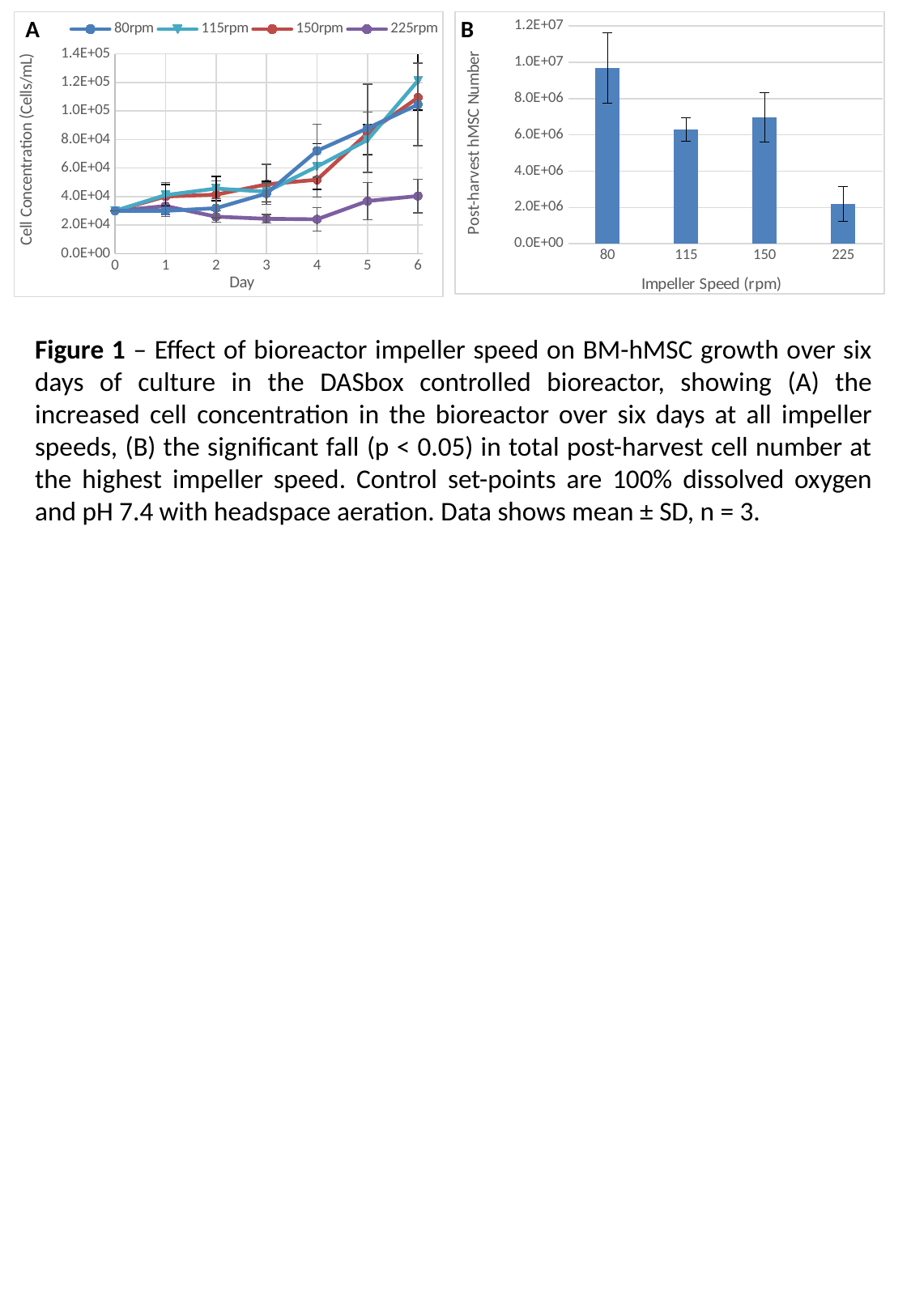
In chart B, is the post-harvest hMSC number for 80 rpm greater or less than 8.0E+06? greater In chart B, is the post-harvest hMSC number for 150 rpm greater or less than 8.0E+06? less In chart B, which impeller speed has the highest post-harvest hMSC number? 80 In chart B, is the post-harvest hMSC number for 225 rpm greater or less than 4.0E+06? less How many series does the legend of chart A list? 4 In chart B, which has a larger post-harvest hMSC number, 80 rpm or 225 rpm? 80 rpm How many impeller speeds are plotted as bars in chart B? 4 What kind of chart is chart A? line chart In chart A, does the cell concentration for 80rpm rise or fall from day 0 to day 6? rise In chart B, which impeller speed has the lowest post-harvest hMSC number? 225 What kind of chart is chart B? bar chart